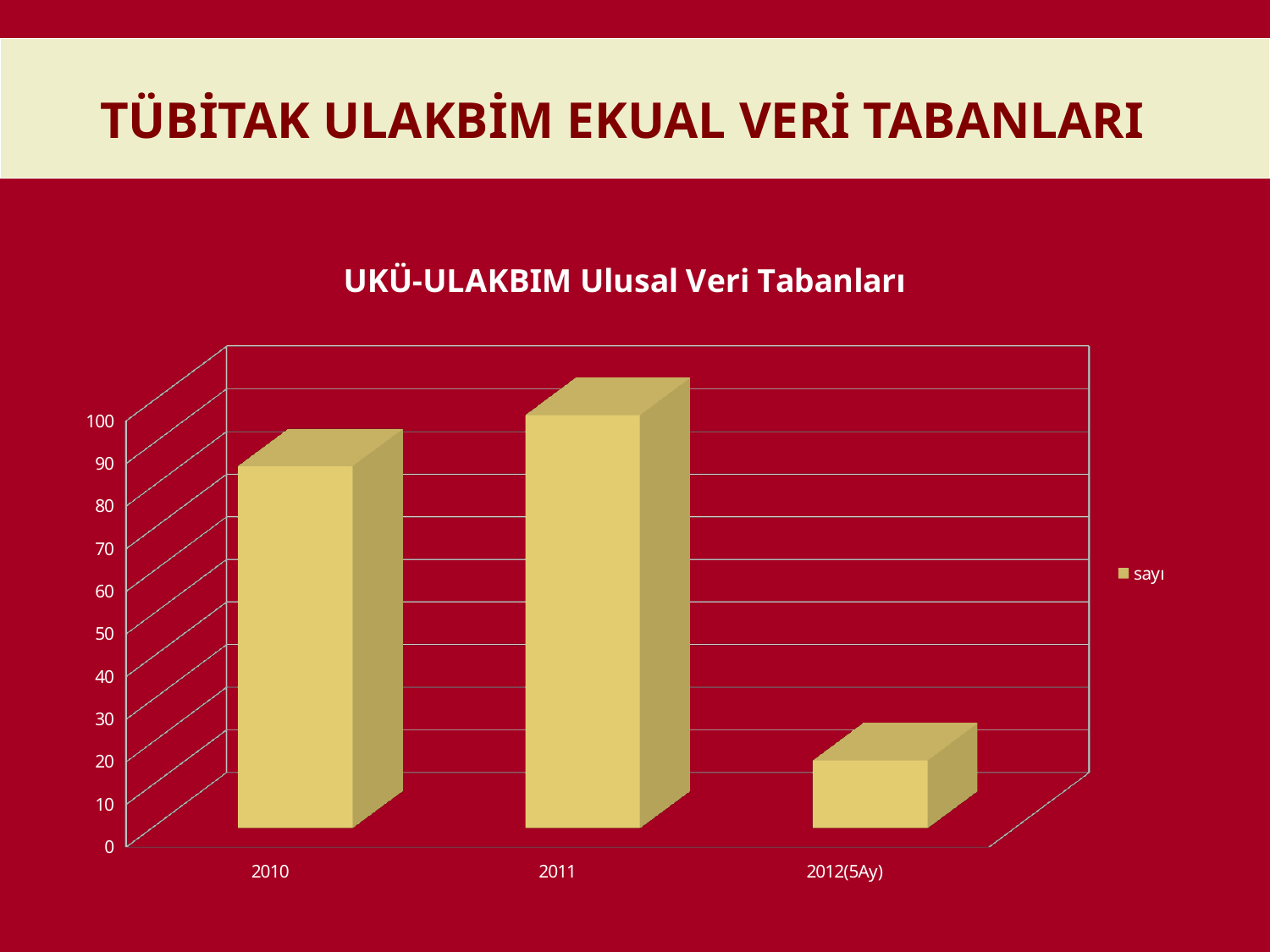
What type of chart is shown on the slide? bar chart How many series does the legend list? 1 Does the value rise or fall from 2011 to 2012(5Ay)? fall What is the title of the chart? UKÜ-ULAKBIM Ulusal Veri Tabanları Which is larger, the value for 2010 or the value for 2011? 2011 Which category has the highest value? 2011 Is the value for 2011 greater or less than 90? greater Which category has the lowest value? 2012(5Ay) What is the name of the series shown in the legend? sayı How many categories are shown on the x axis? 3 Is the value for 2012(5Ay) greater or less than 30? less Is the value for 2010 greater or less than 80? greater